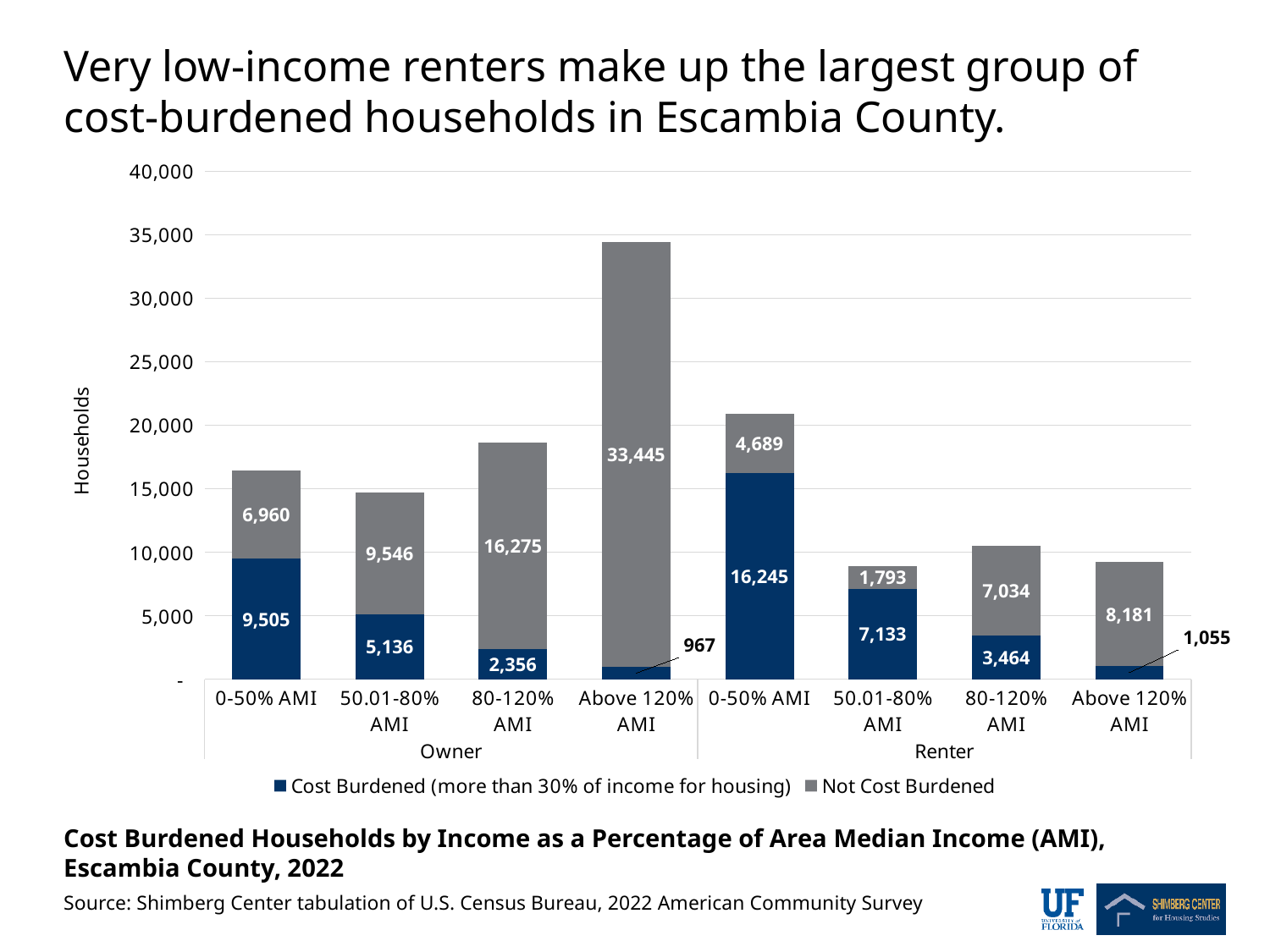
What is the total number of renter households in the 50.01-80% AMI group? 8,926 What kind of chart is shown on the slide? Stacked bar chart What is the number of not cost-burdened renter households in the 80-120% AMI group? 7,034 Which is larger: the number of not cost-burdened owner households in the 50.01-80% AMI group or the number of not cost-burdened renter households in the Above 120% AMI group? Owner, 50.01-80% AMI (9,546) What is the number of cost-burdened owner households in the Above 120% AMI group? 967 What is the total number of owner households in the Above 120% AMI group? 34,412 What is the number of cost-burdened owner households in the 0-50% AMI group? 9,505 What is the difference between cost-burdened renter households and cost-burdened owner households in the 0-50% AMI group? 6,740 Which group has the largest number of cost-burdened households? Renter, 0-50% AMI Which group has the smallest number of cost-burdened households? Owner, Above 120% AMI How many series does the legend list? 2 How many income groups are shown on the x axis in total across owners and renters? 8